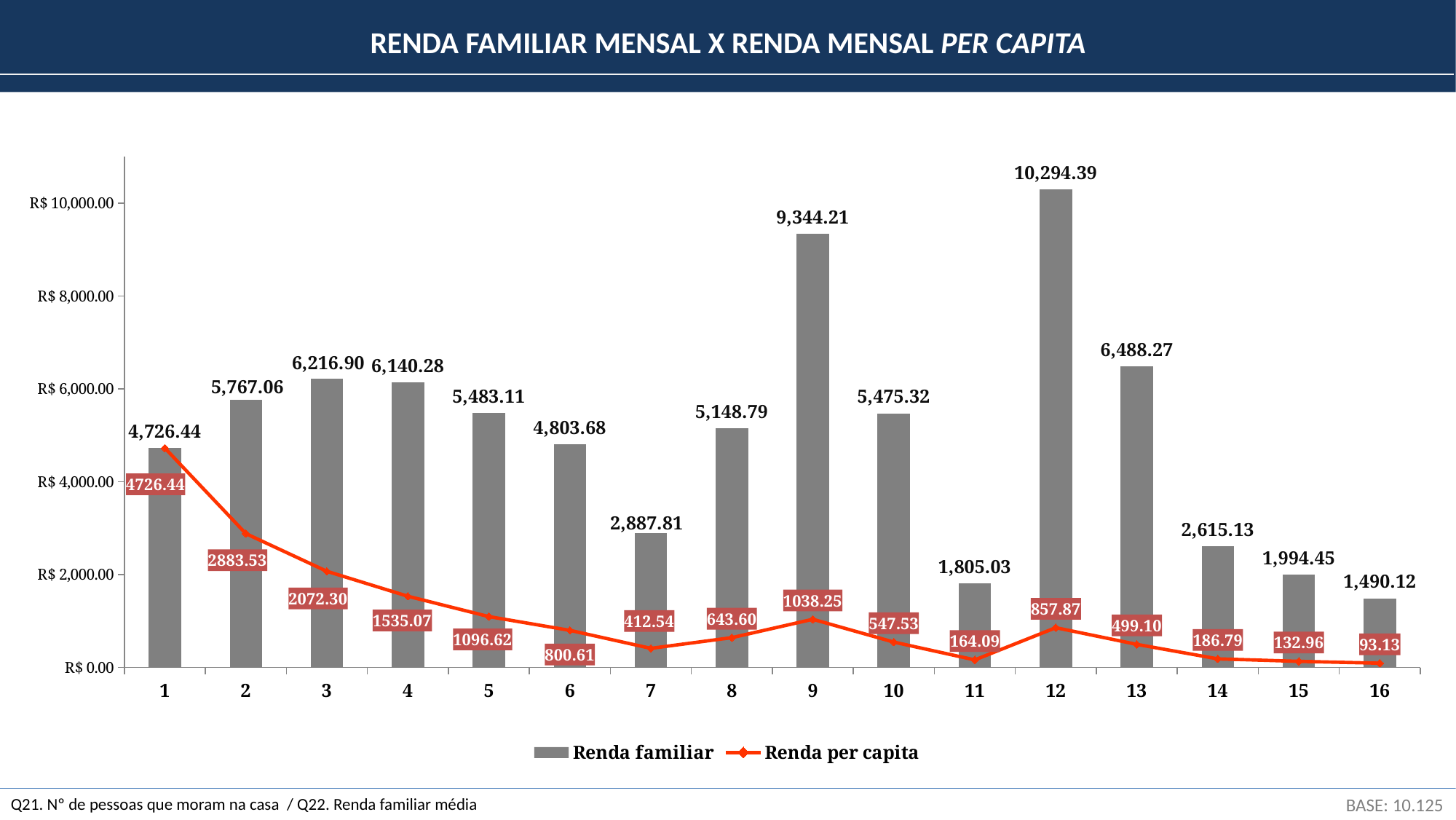
Which category has the lowest Renda per capita value? 16 What kind of chart is shown on the slide? Combined bar and line chart What is the Renda familiar value for category 12? 10,294.39 Which is larger, the Renda familiar value for category 9 or for category 13? Category 9 Does the Renda per capita line generally rise or fall from category 1 to category 16? Fall Which category has the highest Renda familiar value? 12 How many categories are shown on the x axis? 16 What is the Renda per capita value for category 9? 1038.25 What is the Renda familiar value for category 7? 2,887.81 What is the difference between the Renda familiar values for categories 12 and 9? 950.18 Is the Renda familiar value for category 11 greater or less than R$ 2,000.00? less How many series does the legend list? 2